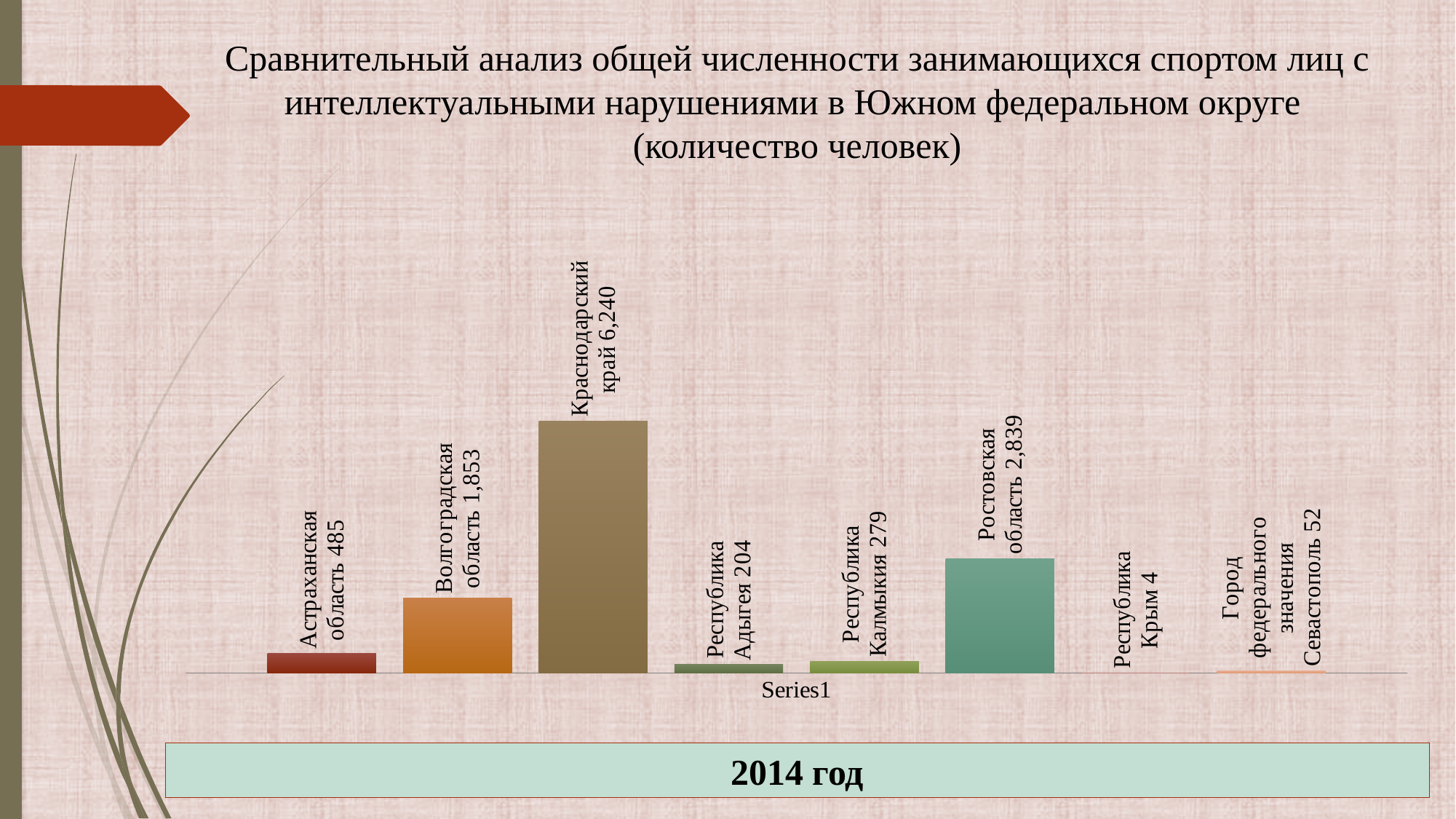
What is the difference between the values for Астраханская область and Республика Калмыкия? 206 What is the difference between the values for Краснодарский край and Ростовская область? 3,401 Which region has the highest value? Краснодарский край Which year does the chart refer to, according to the label below it? 2014 год What is the value for Республика Крым? 4 Which region has the lowest value? Республика Крым Which is larger, the value for Волгоградская область or the value for Ростовская область? Ростовская область What is the value for Город федерального значения Севастополь? 52 What is the value for Краснодарский край? 6,240 How many regions (bars) are shown in the chart? 8 What kind of chart is shown on the slide? Bar chart What is the value for Ростовская область? 2,839